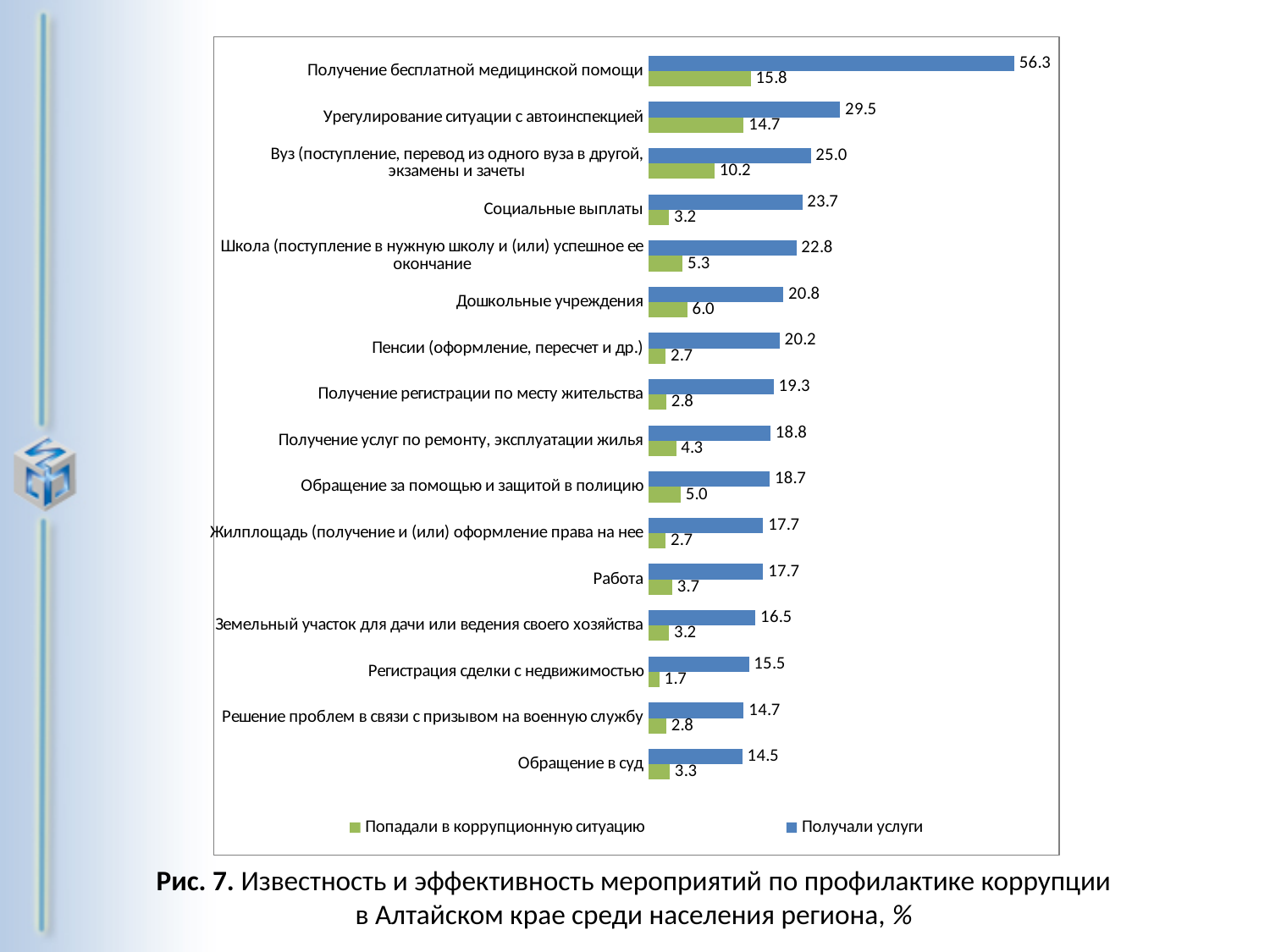
How many categories are shown in the chart? 16 How many series does the legend list? 2 What is the value of "Получали услуги" for "Получение бесплатной медицинской помощи"? 56.3 Which is larger: the "Попадали в коррупционную ситуацию" value for "Дошкольные учреждения" or for "Школа (поступление в нужную школу и (или) успешное ее окончание"? Дошкольные учреждения What is the value of "Попадали в коррупционную ситуацию" for "Регистрация сделки с недвижимостью"? 1.7 Which category has the lowest value for "Попадали в коррупционную ситуацию"? Регистрация сделки с недвижимостью What is the difference between the "Получали услуги" and "Попадали в коррупционную ситуацию" values for "Социальные выплаты"? 20.5 What type of chart is shown on the slide? bar chart What is the value of "Попадали в коррупционную ситуацию" for "Урегулирование ситуации с автоинспекцией"? 14.7 Which category has the lowest value for "Получали услуги"? Обращение в суд Which category has the highest value for "Получали услуги"? Получение бесплатной медицинской помощи Which series is shown in green in the legend? Попадали в коррупционную ситуацию